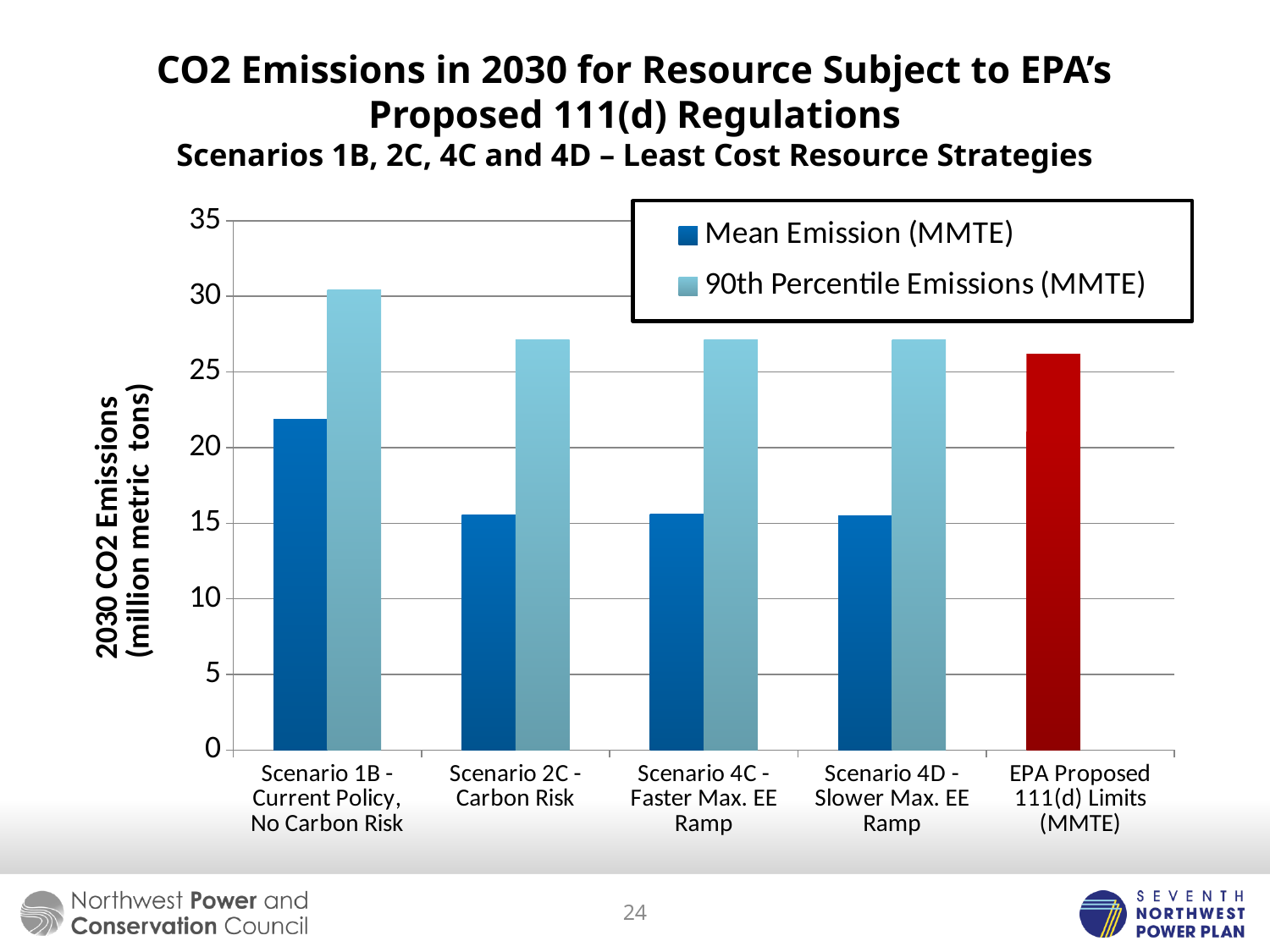
How many series does the legend list? 2 Is the Mean Emission (MMTE) for Scenario 2C - Carbon Risk greater or less than 20? less Is the value for EPA Proposed 111(d) Limits (MMTE) greater or less than 25? greater Which scenario has the highest Mean Emission (MMTE)? Scenario 1B - Current Policy, No Carbon Risk Is the 90th Percentile Emissions (MMTE) for Scenario 4C - Faster Max. EE Ramp greater or less than 25? greater Which is larger: the 90th Percentile Emissions (MMTE) for Scenario 1B - Current Policy, No Carbon Risk or the EPA Proposed 111(d) Limits (MMTE)? Scenario 1B - Current Policy, No Carbon Risk Which scenario has the highest 90th Percentile Emissions (MMTE)? Scenario 1B - Current Policy, No Carbon Risk What kind of chart is shown on the slide? bar chart How many categories are shown along the x axis? 5 Which is larger: the Mean Emission (MMTE) for Scenario 1B - Current Policy, No Carbon Risk or for Scenario 2C - Carbon Risk? Scenario 1B - Current Policy, No Carbon Risk What is the label of the y axis? 2030 CO2 Emissions (million metric tons)